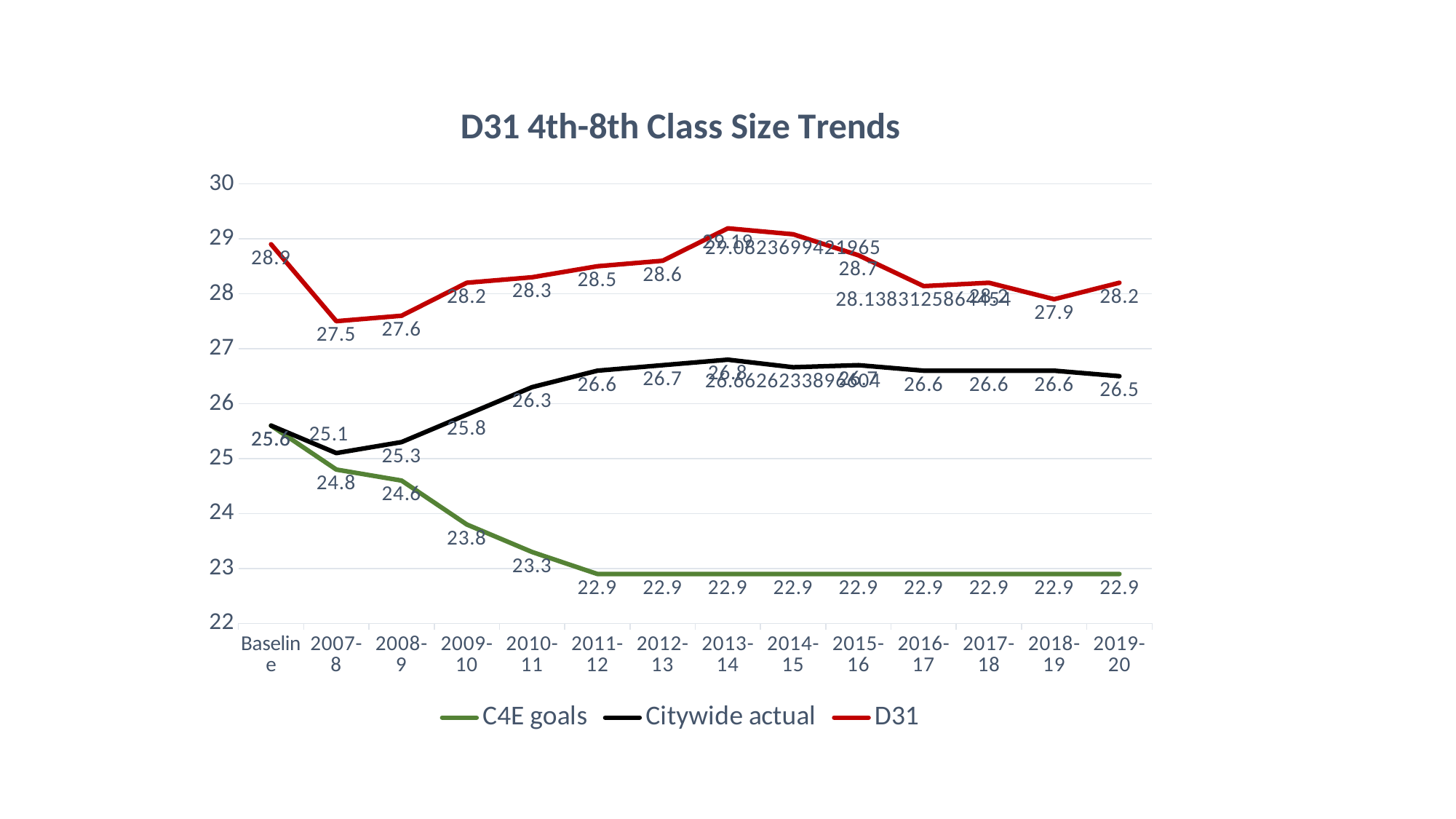
In which year is the Citywide actual value lowest? 2007-8 What kind of chart is shown on the slide? line chart What is the title of the chart? D31 4th-8th Class Size Trends Do the C4E goals values rise or fall from Baseline to 2011-12? fall How many categories are shown along the x axis? 14 What is the difference between the D31 value and the Citywide actual value in 2019-20? 1.7 What is the D31 value for 2018-19? 27.9 What is the C4E goals value for 2009-10? 23.8 Which is larger for D31: the value for 2011-12 or the value for 2018-19? 2011-12 How many series does the legend list? 3 What is the Citywide actual value for 2010-11? 26.3 Is the D31 value for 2013-14 greater or less than 29? greater